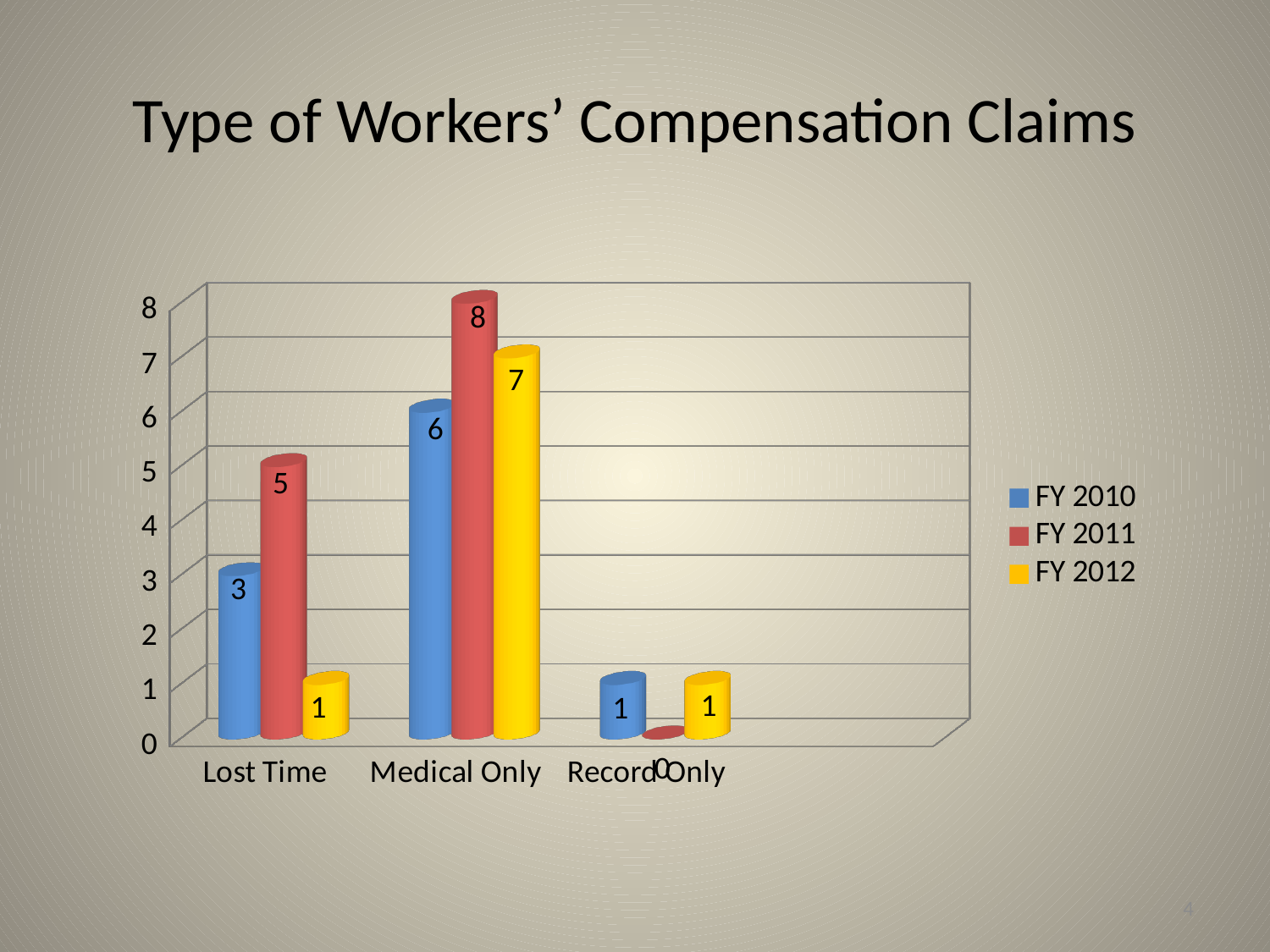
What kind of chart is shown on the slide? Bar chart How many categories are shown on the x axis? 3 How many series does the legend list? 3 Which category has the highest value for FY 2010? Medical Only What is the difference between the FY 2011 and FY 2010 values for Medical Only? 2 What is the value for FY 2011 in the Lost Time category? 5 What is the value for FY 2012 in the Medical Only category? 7 What is the value for FY 2011 in the Record Only category? 0 Which is larger for Lost Time: the FY 2010 value or the FY 2012 value? FY 2010 What is the title of the slide? Type of Workers' Compensation Claims Which category has the lowest value for FY 2011? Record Only What is the value for FY 2010 in the Record Only category? 1